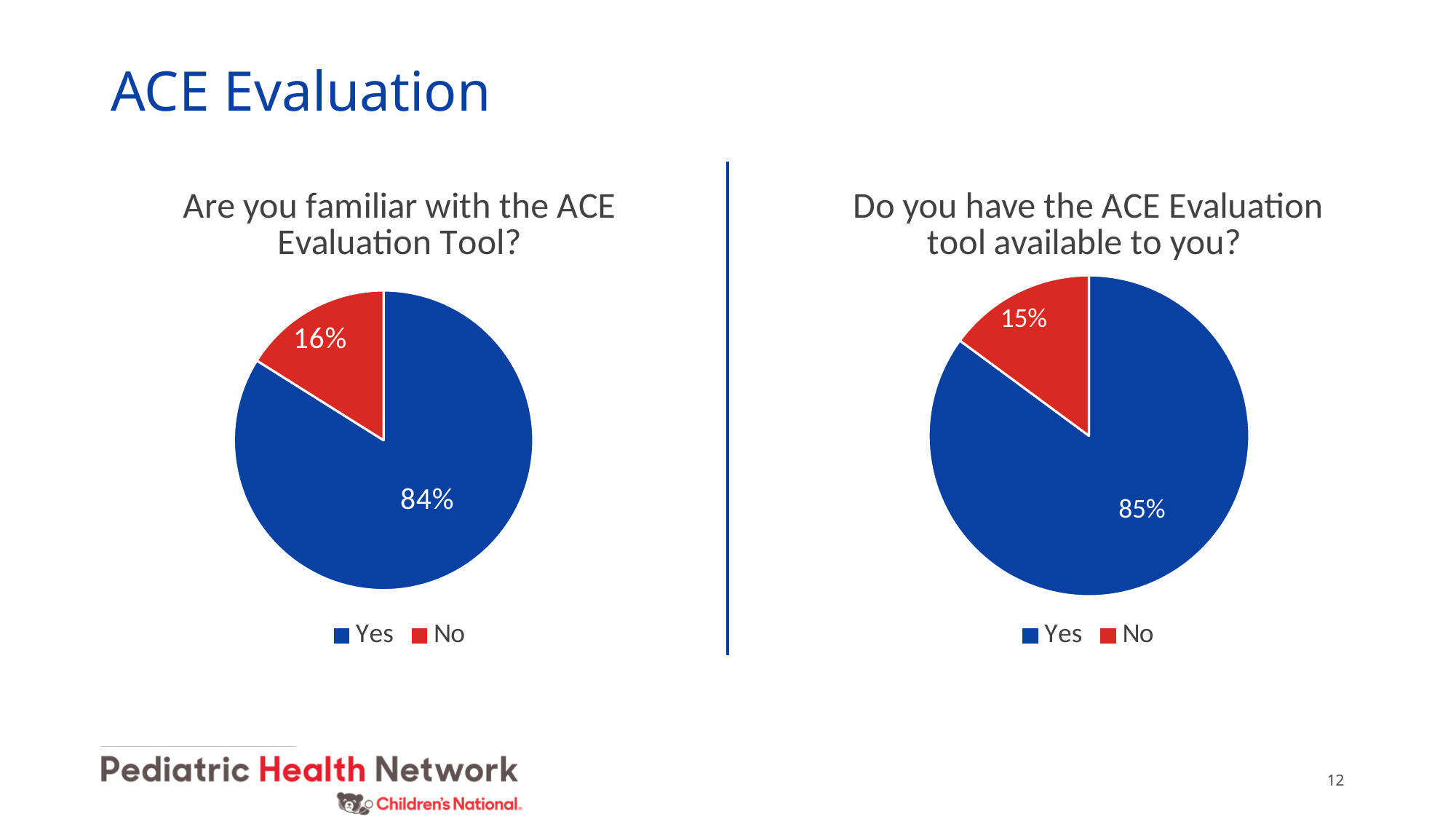
In the chart titled "Do you have the ACE Evaluation tool available to you?", what percentage answered No? 15% In the chart titled "Are you familiar with the ACE Evaluation Tool?", what percentage answered Yes? 84% How many categories does the legend of the right chart list? 2 In the right chart, which response has the smallest slice? No Is the No share larger in the left chart or the right chart? Left chart In the chart titled "Do you have the ACE Evaluation tool available to you?", what percentage answered Yes? 85% In the left chart, what colour is the Yes slice? Blue In the left chart, what is the difference between the Yes and No percentages? 68% In the right chart, what is the difference between the Yes and No percentages? 70% In the chart titled "Are you familiar with the ACE Evaluation Tool?", what percentage answered No? 16% What type of chart is used on the left side of the slide? Pie chart In the left chart, which response has the largest slice? Yes